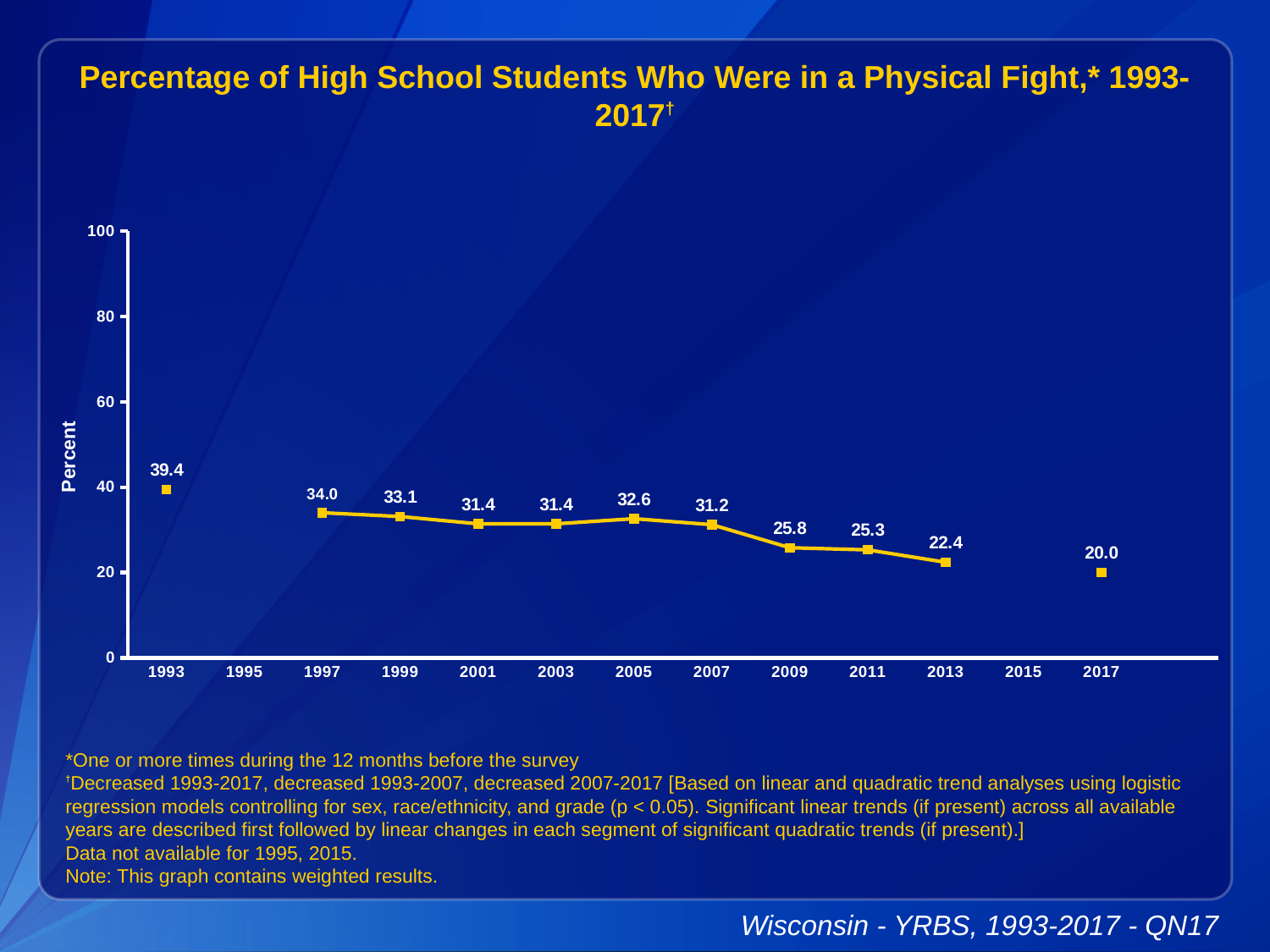
What is the value for 1993? 39.4 What is the value for 2005? 32.6 Which year has the lowest value? 2017 Which is larger, the value for 2009 or the value for 2011? 2009 What kind of chart is this? line chart What is the value for 2017? 20.0 Do the values generally rise or fall from 1993 to 2017? fall Is the value for 2013 greater or less than 40? less What is the difference between the values for 1993 and 2017? 19.4 Which year has the highest value? 1993 What is the label on the y axis? Percent How many years have data points plotted? 11